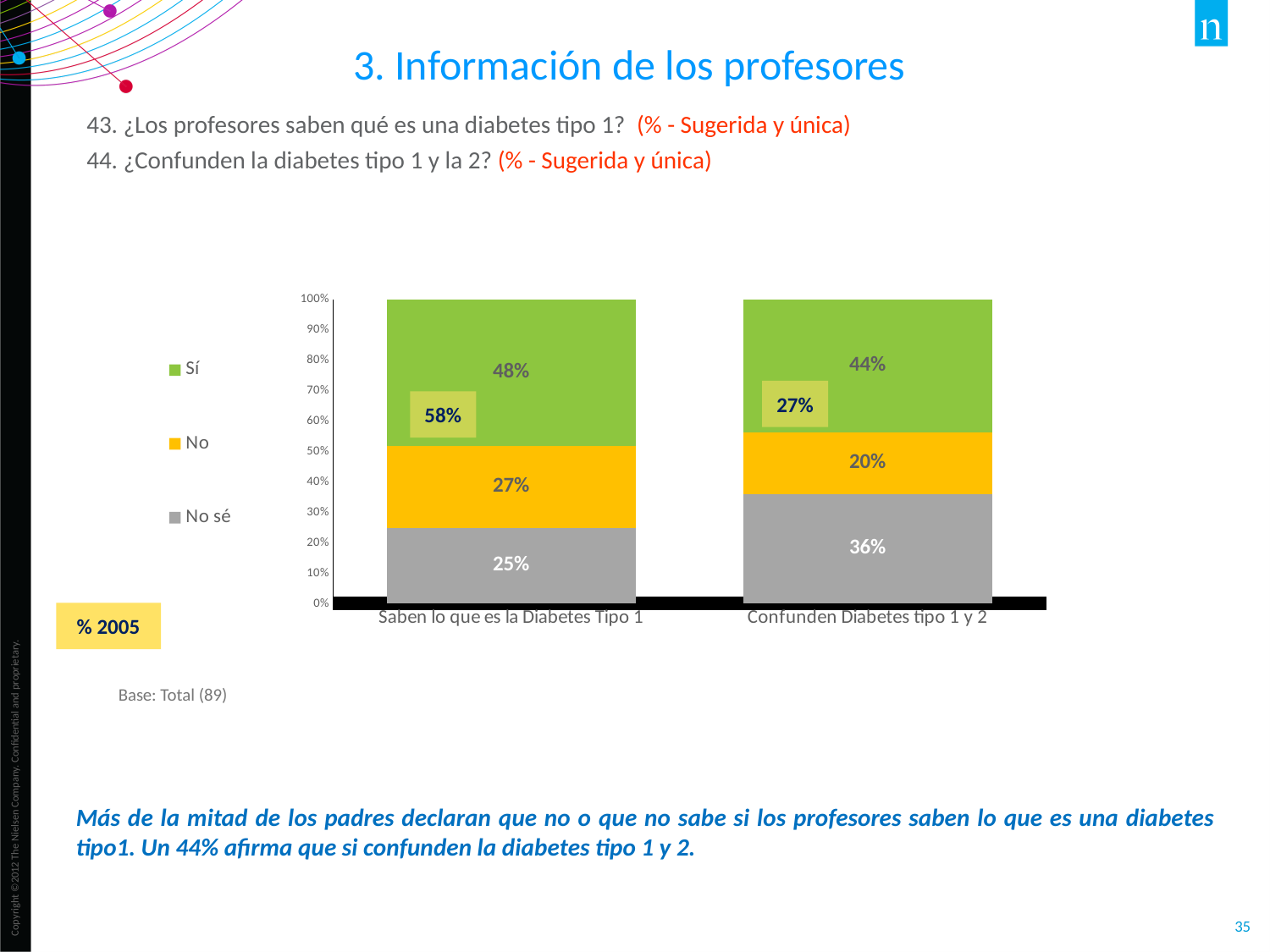
How many categories are shown on the x axis? 2 What kind of chart is shown on the slide? Stacked bar chart What is the difference between the 'No sé' values for 'Confunden Diabetes tipo 1 y 2' and 'Saben lo que es la Diabetes Tipo 1'? 11% Which is larger: the 'Sí' value for 'Saben lo que es la Diabetes Tipo 1' or for 'Confunden Diabetes tipo 1 y 2'? Saben lo que es la Diabetes Tipo 1 What colour represents the 'No' series in the chart? Yellow What is the value of 'Sí' for 'Saben lo que es la Diabetes Tipo 1'? 48% Which series has the highest value for 'Confunden Diabetes tipo 1 y 2'? Sí What is the value of 'No' for 'Saben lo que es la Diabetes Tipo 1'? 27% How many series does the legend list? 3 Which series has the lowest value for 'Saben lo que es la Diabetes Tipo 1'? No sé What is the value of 'No sé' for 'Confunden Diabetes tipo 1 y 2'? 36% What is the value of 'No' for 'Confunden Diabetes tipo 1 y 2'? 20%